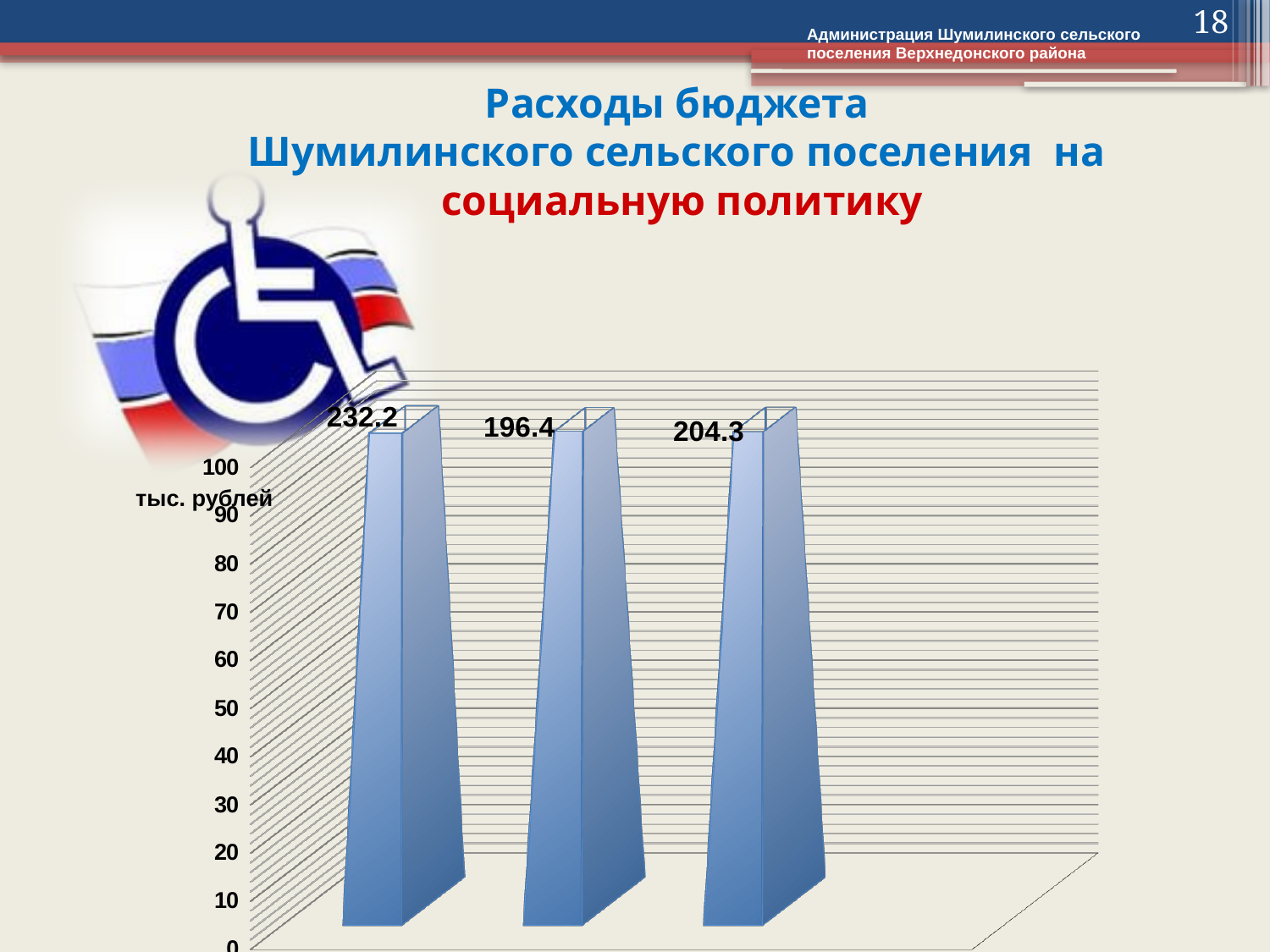
How many bars are plotted on the chart? 3 What is the value shown on the first (leftmost) bar? 232.2 Which is larger, the value of the second bar or the value of the third bar? the third bar Which bar has the lowest value: the first, second or third? the second Does the value fall or rise from the first bar to the second bar? fall What is the value shown on the middle bar? 196.4 Which bar has the highest value: the first, second or third? the first What is the difference between the values of the first bar and the second bar? 35.8 What is the difference between the values of the third bar and the second bar? 7.9 What is the value shown on the third (rightmost) bar? 204.3 What unit is written next to the vertical axis of the chart? тыс. рублей What kind of chart is shown on the slide? bar chart